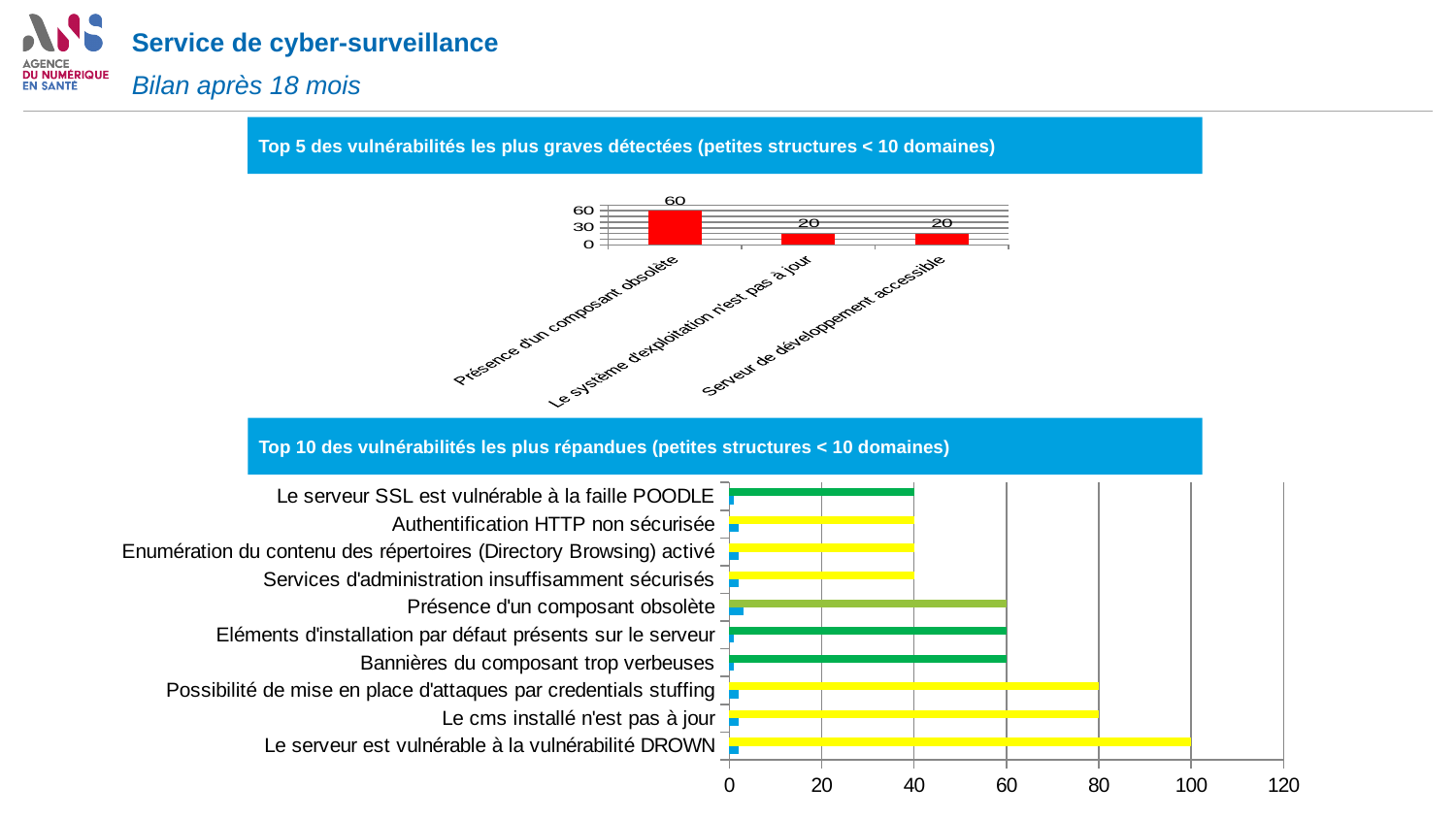
In the 'Top 10 des vulnérabilités les plus répandues' chart, how many categories are listed? 10 In the 'Top 5 des vulnérabilités les plus graves détectées' chart, how many categories are plotted? 3 In the 'Top 5 des vulnérabilités les plus graves détectées' chart, what is the value for 'Présence d'un composant obsolète'? 60 In the 'Top 10 des vulnérabilités les plus répandues' chart, which is larger: the long bar for 'Bannières du composant trop verbeuses' or for 'Authentification HTTP non sécurisée'? Bannières du composant trop verbeuses In the 'Top 10 des vulnérabilités les plus répandues' chart, what is the value of the long bar for 'Le serveur est vulnérable à la vulnérabilité DROWN'? 100 In the 'Top 10 des vulnérabilités les plus répandues' chart, which category has the longest bar? Le serveur est vulnérable à la vulnérabilité DROWN In the 'Top 5 des vulnérabilités les plus graves détectées' chart, what is the value for 'Serveur de développement accessible'? 20 What kind of chart is the 'Top 10 des vulnérabilités les plus répandues' chart? Bar chart In the 'Top 5 des vulnérabilités les plus graves détectées' chart, what is the difference between 'Présence d'un composant obsolète' and 'Le système d'exploitation n'est pas à jour'? 40 In the 'Top 10 des vulnérabilités les plus répandues' chart, is the long bar for 'Possibilité de mise en place d'attaques par credentials stuffing' greater or less than 60? greater In the 'Top 5 des vulnérabilités les plus graves détectées' chart, which category has the highest value? Présence d'un composant obsolète In the 'Top 10 des vulnérabilités les plus répandues' chart, what is the value of the long bar for 'Le cms installé n'est pas à jour'? 80